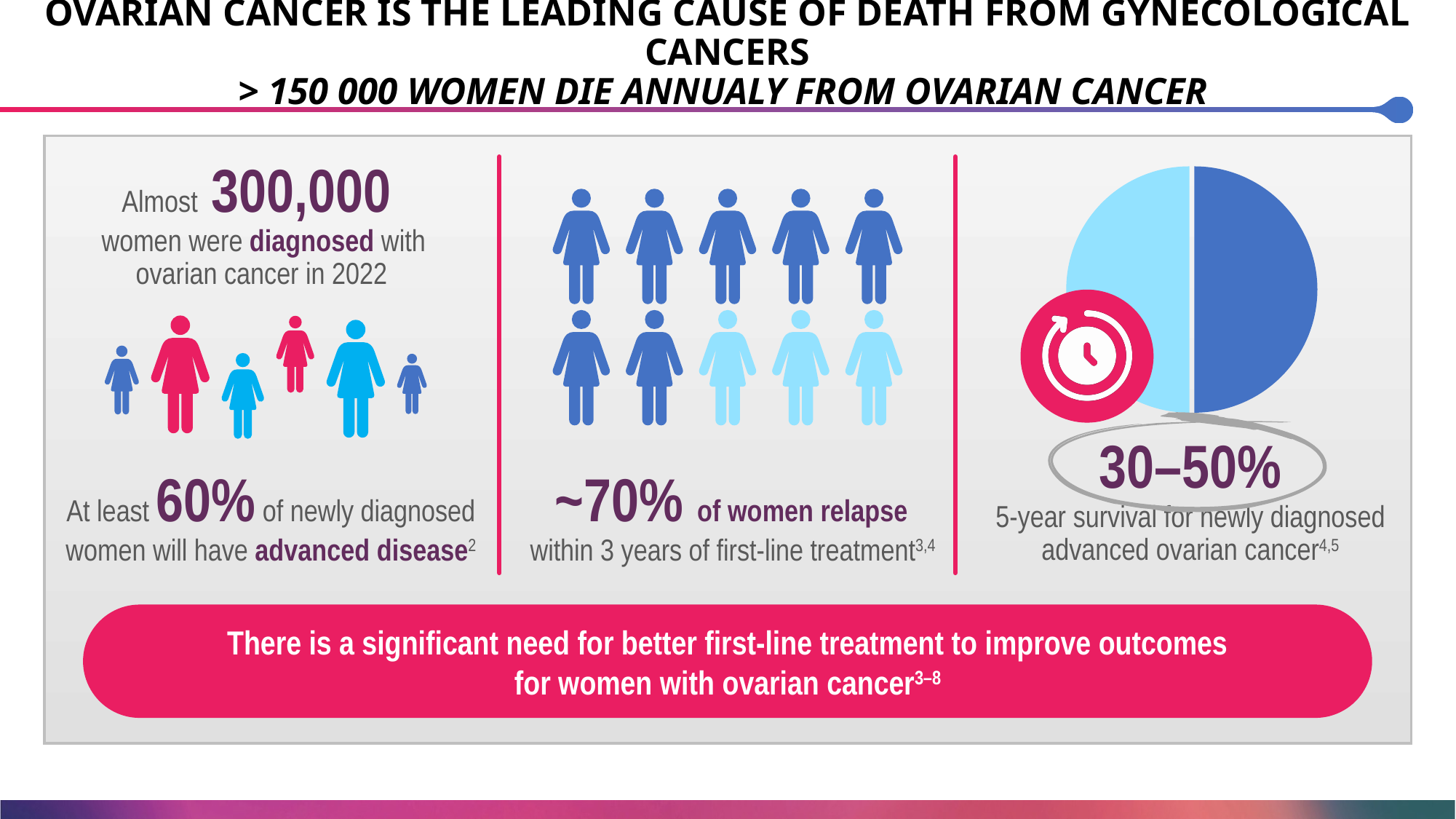
In the middle panel pictogram, how many of the person icons are dark blue? 7 According to the middle panel, what proportion of women relapse within 3 years of first-line treatment? ~70% What kind of chart is shown in the right-hand panel of the infographic? pie chart How many person icons are shown in the left panel of the infographic? 6 According to the left panel, how many women were diagnosed with ovarian cancer in 2022? Almost 300,000 What two colours are used for the slices of the pie chart in the right-hand panel? light blue and dark blue How many slices does the pie chart in the right-hand panel have? 2 What 5-year survival figure is printed below the pie chart for newly diagnosed advanced ovarian cancer? 30–50% According to the left panel, what percentage of newly diagnosed women will have advanced disease? At least 60% What icon overlaps the lower-left of the pie chart in the right-hand panel? a clock icon